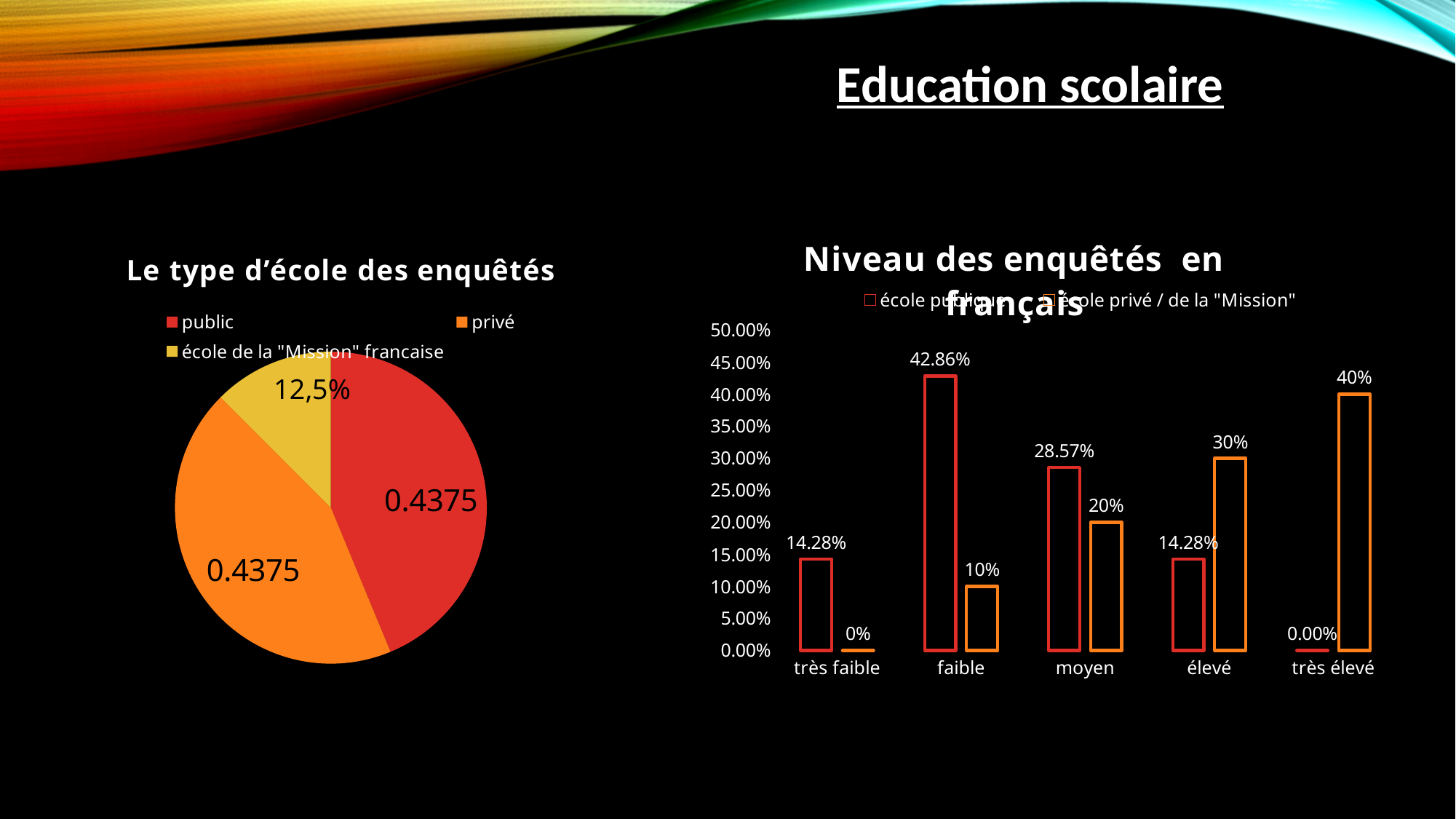
How many categories are shown on the x axis of the bar chart 'Niveau des enquêtés en français'? 5 In the bar chart 'Niveau des enquêtés en français', what is the difference between the école privé / de la "Mission" values for 'élevé' and 'moyen'? 10% In the bar chart 'Niveau des enquêtés en français', which category has the lowest value for école privé / de la "Mission"? très faible In the bar chart 'Niveau des enquêtés en français', what is the value for école publique in the 'faible' category? 42.86% In the bar chart 'Niveau des enquêtés en français', which is larger in the 'élevé' category: école publique or école privé / de la "Mission"? école privé / de la "Mission" In the bar chart 'Niveau des enquêtés en français', what is the value for école publique in the 'moyen' category? 28.57% In the bar chart 'Niveau des enquêtés en français', which category has the highest value for école publique? faible How many series does the legend of the bar chart 'Niveau des enquêtés en français' list? 2 In the bar chart 'Niveau des enquêtés en français', do the école privé / de la "Mission" values rise or fall from 'très faible' to 'très élevé'? rise In the pie chart 'Le type d'école des enquêtés', what is the value shown for école de la "Mission" francaise? 12,5% What kind of chart is 'Le type d'école des enquêtés'? pie chart In the bar chart 'Niveau des enquêtés en français', what is the value for école privé / de la "Mission" in the 'très élevé' category? 40%